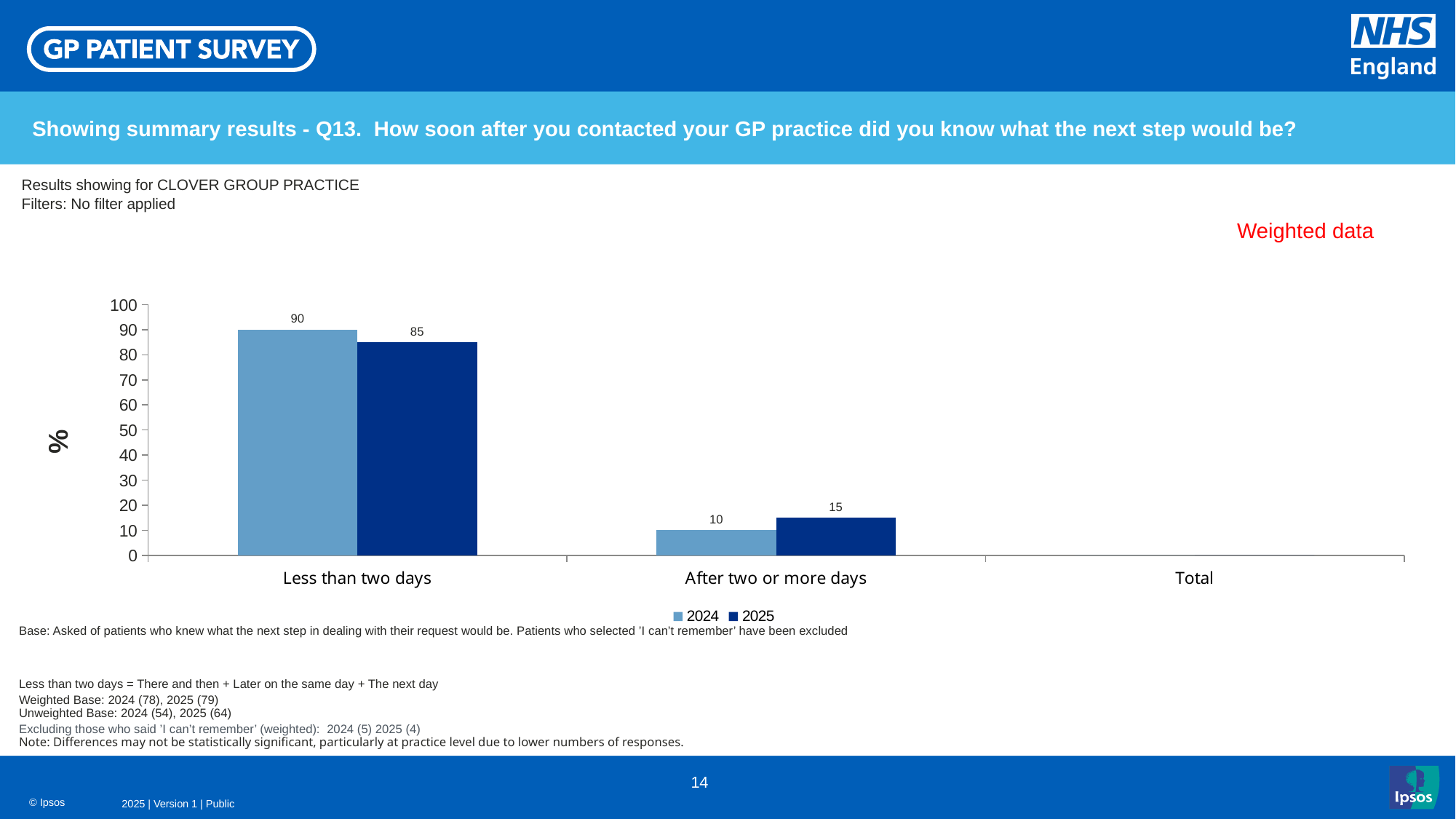
What is the 2024 value for 'Less than two days'? 90 What kind of chart is shown on the slide? Bar chart How many series does the legend list? 2 For 'After two or more days', which year has the larger value, 2024 or 2025? 2025 What is the 2024 value for 'After two or more days'? 10 What label is shown on the y axis? % Which series is shown in the darker blue colour? 2025 What is the difference between the 2024 and 2025 values for 'Less than two days'? 5 Which category has the lowest 2024 value? After two or more days What is the 2025 value for 'After two or more days'? 15 Which category has the highest 2025 value? Less than two days What is the 2025 value for 'Less than two days'? 85